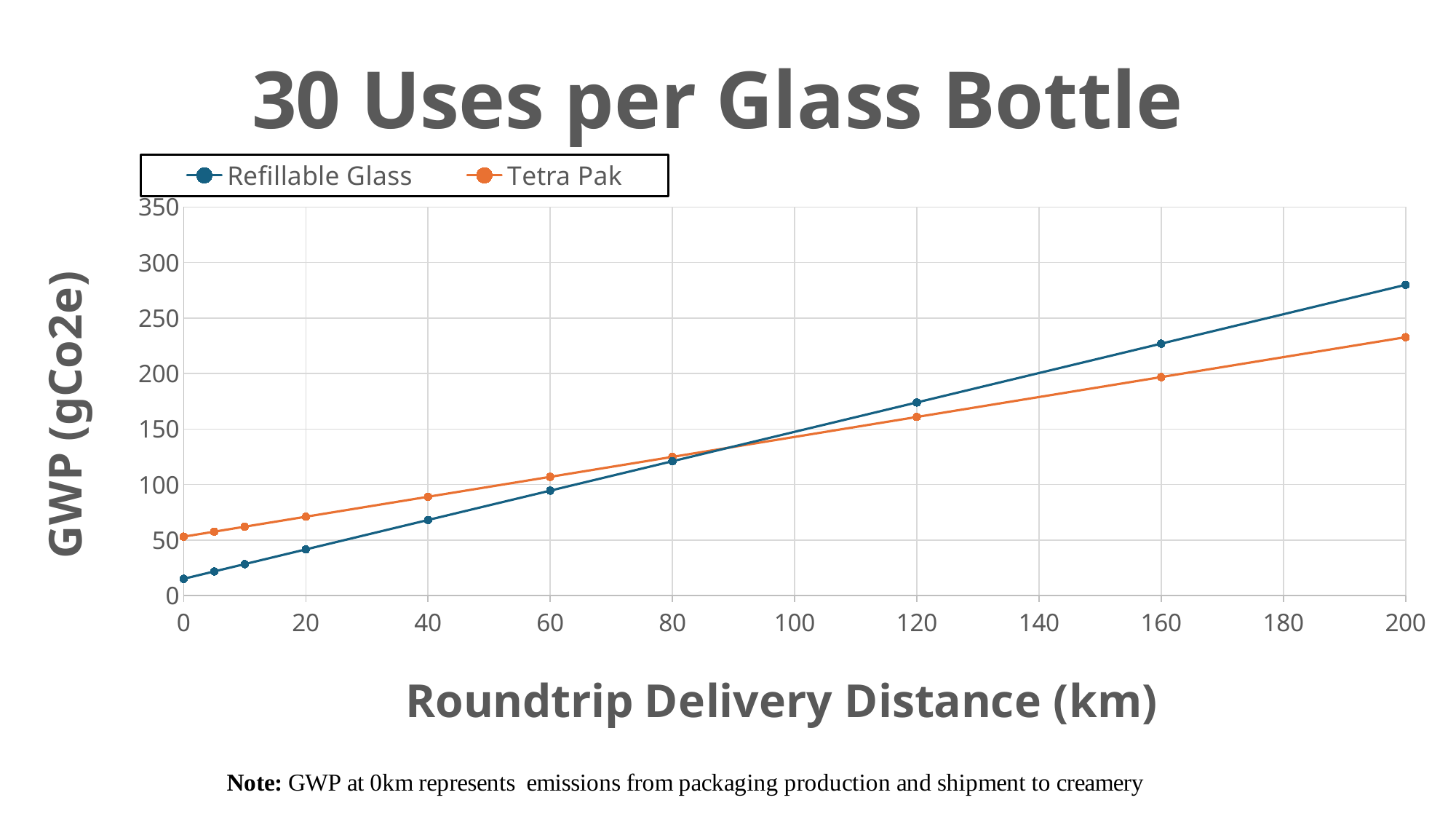
How many data points are plotted for the Refillable Glass series? 10 Is the GWP value for Refillable Glass at 0 km greater or less than 50? less Is the GWP value for Tetra Pak at 200 km greater or less than 250? less Is the GWP value for Refillable Glass at 200 km greater or less than 250? greater At 0 km roundtrip delivery distance, which series has the higher GWP, Refillable Glass or Tetra Pak? Tetra Pak At 200 km roundtrip delivery distance, which series has the higher GWP, Refillable Glass or Tetra Pak? Refillable Glass How many series does the legend list? 2 Do the GWP values for Tetra Pak rise or fall as roundtrip delivery distance increases? rise What is the title of the chart? 30 Uses per Glass Bottle What kind of chart is shown on the slide? line chart